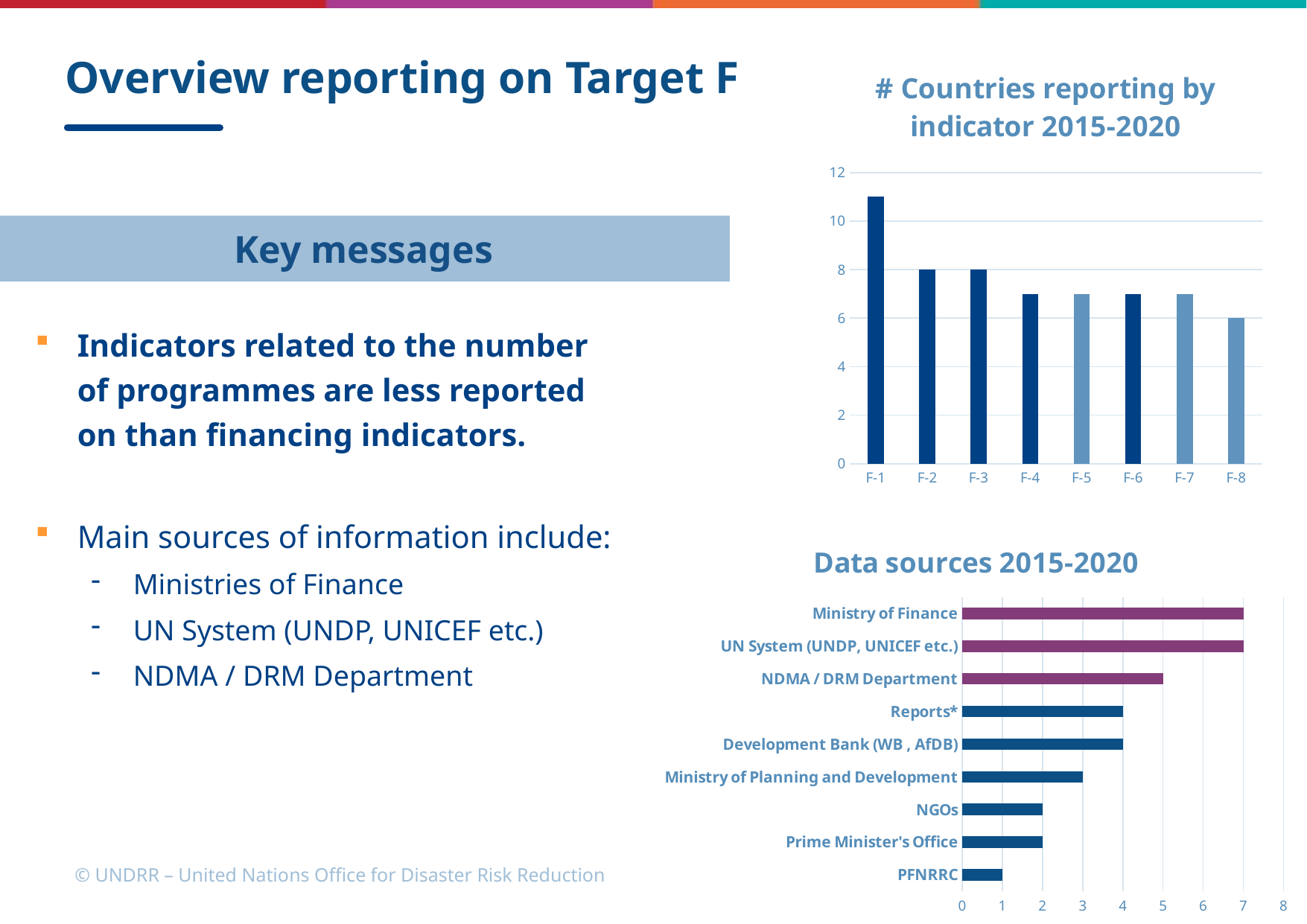
In the '# Countries reporting by indicator 2015-2020' chart, is the value for F-1 greater or less than 10? greater In the '# Countries reporting by indicator 2015-2020' chart, which indicator has the highest number of countries reporting? F-1 In the '# Countries reporting by indicator 2015-2020' chart, which is larger, the value for F-2 or the value for F-8? F-2 In the 'Data sources 2015-2020' chart, what is the value for NDMA / DRM Department? 5 In the 'Data sources 2015-2020' chart, what is the value for Ministry of Planning and Development? 3 In the 'Data sources 2015-2020' chart, how many data sources are listed? 9 In the 'Data sources 2015-2020' chart, what is the difference between the value for Ministry of Finance and the value for Reports*? 3 In the 'Data sources 2015-2020' chart, which data source has the lowest value? PFNRRC In the '# Countries reporting by indicator 2015-2020' chart, which indicator has the lowest number of countries reporting? F-8 In the '# Countries reporting by indicator 2015-2020' chart, what is the value for F-8? 6 In the '# Countries reporting by indicator 2015-2020' chart, what kind of chart is shown? bar chart In the '# Countries reporting by indicator 2015-2020' chart, how many indicators are plotted? 8